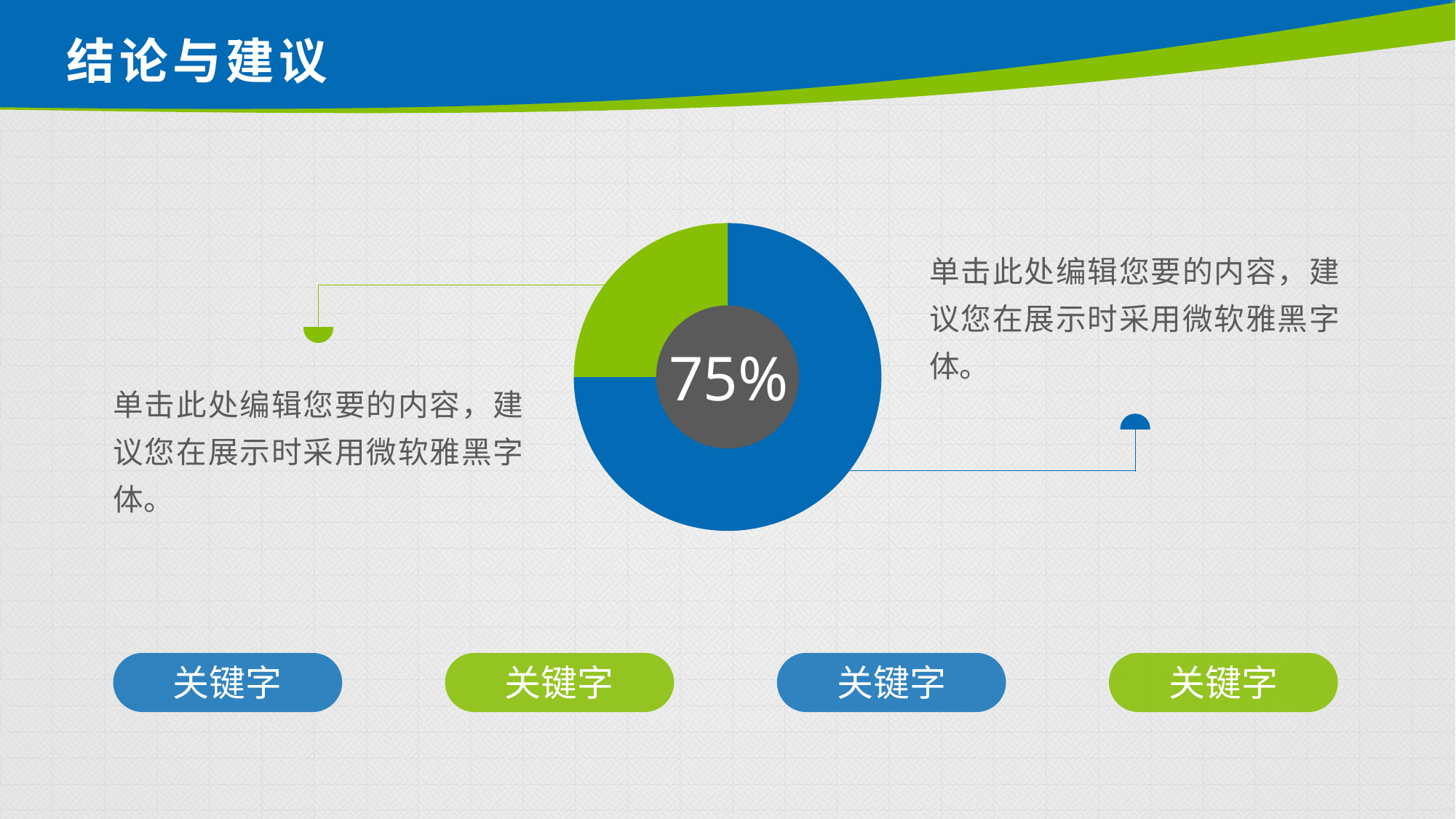
What colour is the centre circle of the doughnut chart that holds the percentage label? dark grey Which colour slice takes up the largest share of the doughnut chart? blue What share of the doughnut chart does the blue slice represent? 75% Which colour slice takes up the smallest share of the doughnut chart? green What percentage is printed in the centre of the doughnut chart? 75% Is the blue slice of the doughnut chart greater or less than half of the chart? greater What kind of chart is shown on the slide? doughnut chart Is the green slice of the doughnut chart greater or less than half of the chart? less Which slice of the doughnut chart is larger, the blue one or the green one? blue What is the title of the slide containing the doughnut chart? 结论与建议 How many slices does the doughnut chart have? 2